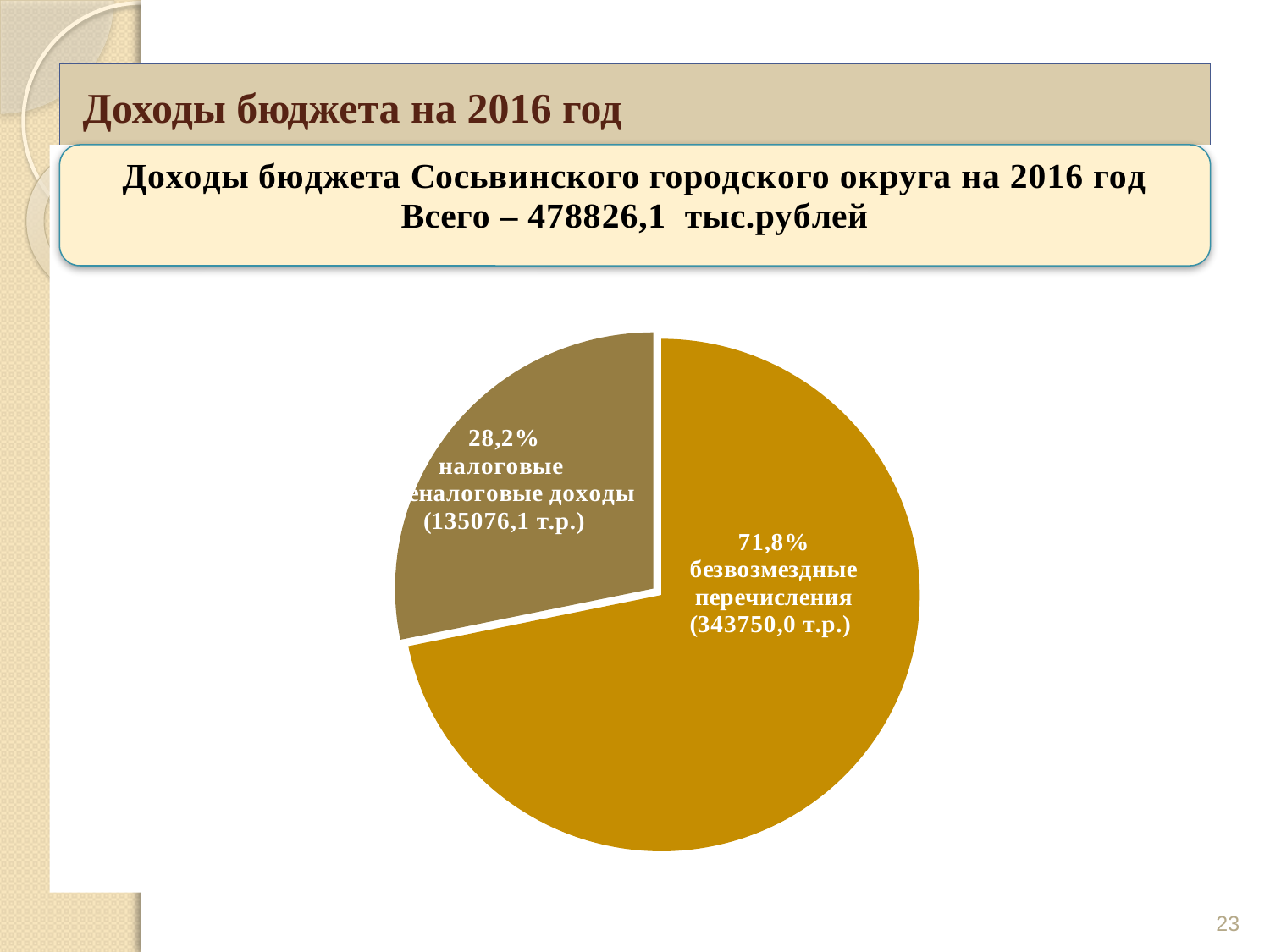
By how many percentage points does the share of "безвозмездные перечисления" exceed that of "налоговые и неналоговые доходы"? 43,6% Which slice of the pie is the smallest? налоговые и неналоговые доходы Which slice of the pie is the largest? безвозмездные перечисления What share of the pie is labelled "налоговые и неналоговые доходы"? 28,2% What share of the pie is labelled "безвозмездные перечисления"? 71,8% What value in т.р. is shown for "безвозмездные перечисления"? 343750,0 т.р. Which is larger: "безвозмездные перечисления" or "налоговые и неналоговые доходы"? безвозмездные перечисления What kind of chart is shown on the slide? Pie chart What is the difference in т.р. between "безвозмездные перечисления" and "налоговые и неналоговые доходы"? 208673,9 т.р. What total amount of budget revenue for 2016 is stated above the chart? 478826,1 тыс.рублей How many slices does the pie chart have? 2 What value in т.р. is shown for "налоговые и неналоговые доходы"? 135076,1 т.р.